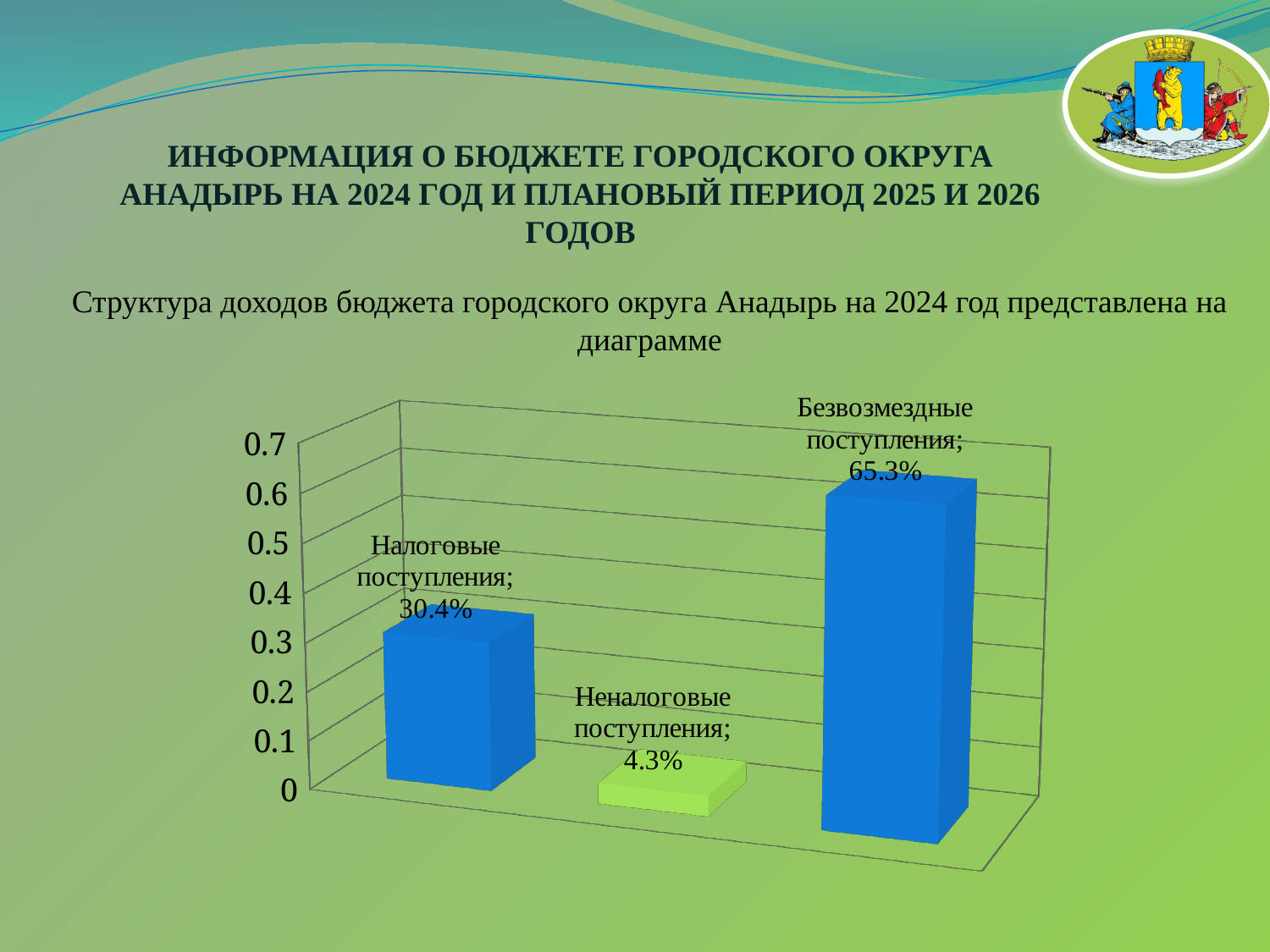
What is the difference between the values for Налоговые поступления and Неналоговые поступления? 26.1% What is the value shown for Неналоговые поступления? 4.3% What is the highest value marked on the vertical axis of the chart? 0.7 What is the value shown for Налоговые поступления? 30.4% How many categories are plotted in the chart? 3 Which category has the highest value? Безвозмездные поступления Which category has the lowest value? Неналоговые поступления Is the value for Безвозмездные поступления greater or less than 0.5 on the axis? greater What is the difference between the values for Безвозмездные поступления and Налоговые поступления? 34.9% What is the value shown for Безвозмездные поступления? 65.3% What kind of chart is shown on the slide? bar chart Which is larger, the value for Налоговые поступления or the value for Неналоговые поступления? Налоговые поступления